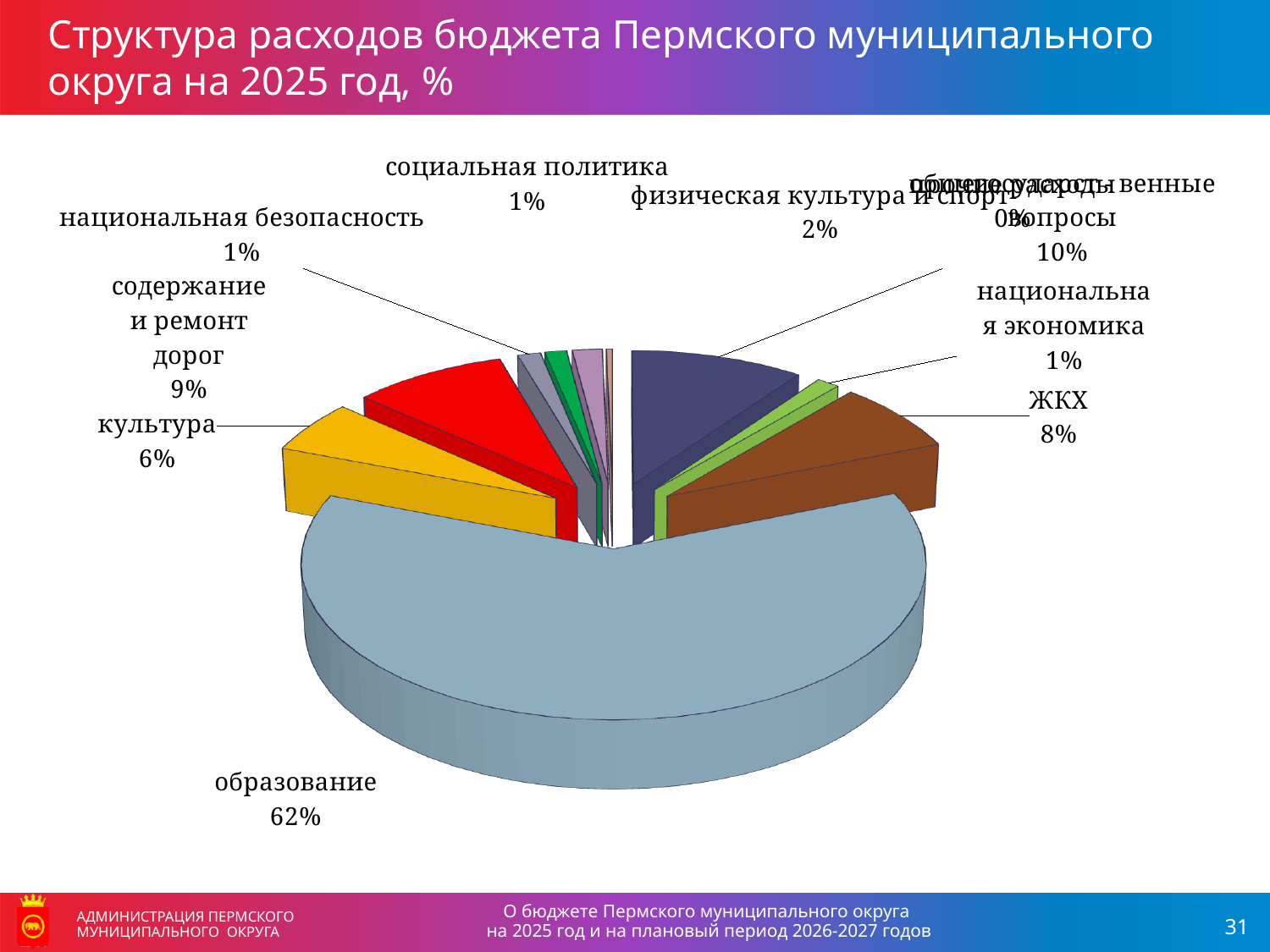
By how many percentage points does the share of образование exceed the share of общегосударственные вопросы? 52 What share of the budget expenditure goes to образование? 62% Which has a larger share: общегосударственные вопросы or содержание и ремонт дорог? общегосударственные вопросы What kind of chart is shown on the slide? pie chart What share of the budget expenditure goes to физическая культура и спорт? 2% What year does the chart title say the budget expenditure structure refers to? 2025 Which has a larger share: ЖКХ or культура? ЖКХ What share of the budget expenditure goes to общегосударственные вопросы? 10% What share of the budget expenditure goes to содержание и ремонт дорог? 9% What share of the budget expenditure goes to ЖКХ? 8% What share of the budget expenditure goes to культура? 6% Which category has the largest share of the budget expenditure? образование